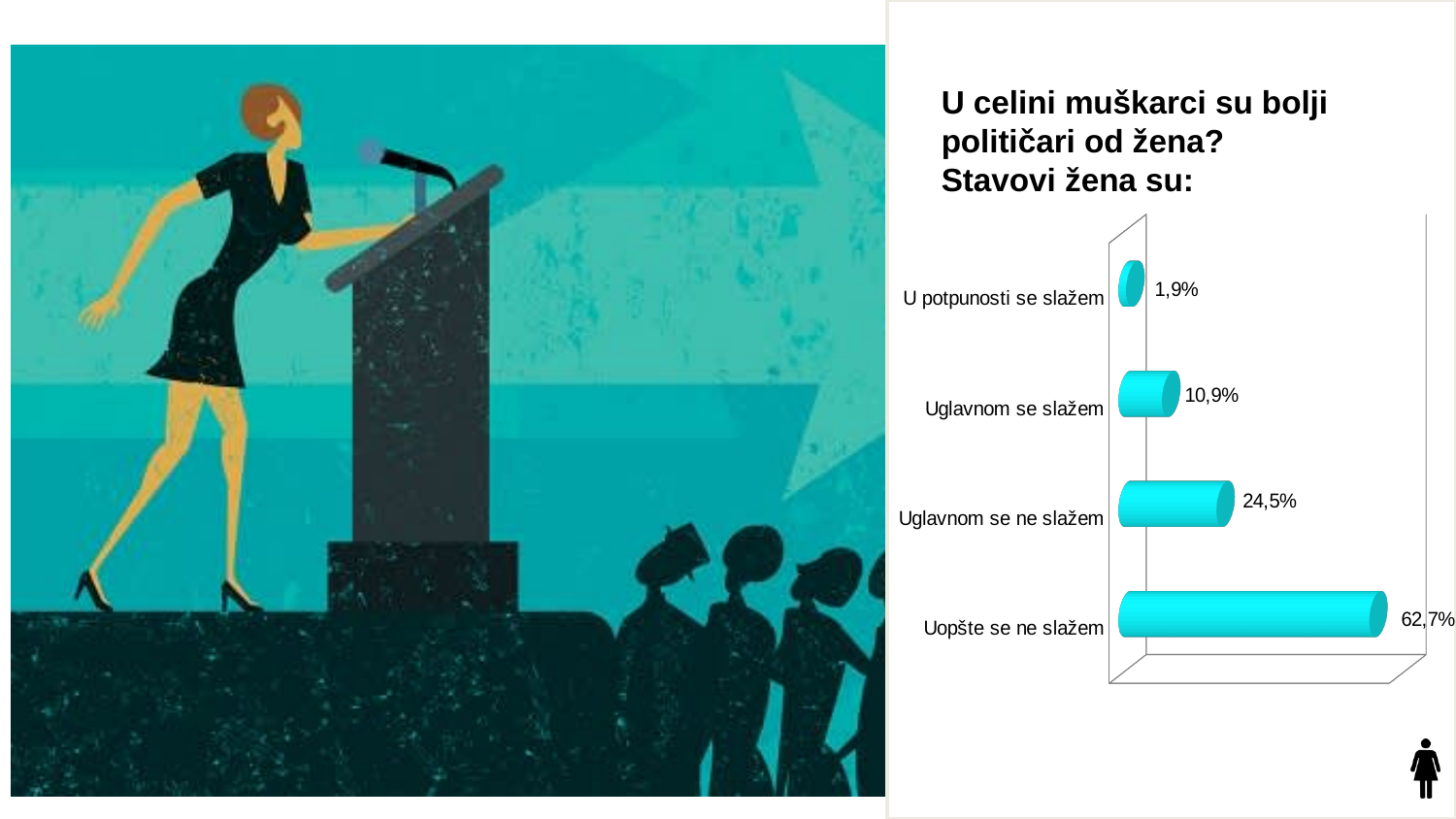
What is the value for "Uopšte se ne slažem"? 62,7% What is the difference between the values for "Uopšte se ne slažem" and "Uglavnom se ne slažem"? 38,2% What is the value for "Uglavnom se ne slažem"? 24,5% What is the title of the chart? U celini muškarci su bolji političari od žena? Stavovi žena su: How many categories are shown in the chart? 4 What is the difference between the values for "Uglavnom se slažem" and "U potpunosti se slažem"? 9,0% Which is larger, the value for "Uglavnom se ne slažem" or the value for "Uglavnom se slažem"? Uglavnom se ne slažem Which category has the highest value? Uopšte se ne slažem What is the value for "U potpunosti se slažem"? 1,9% Which category has the lowest value? U potpunosti se slažem What kind of chart is shown on the slide? Bar chart What is the value for "Uglavnom se slažem"? 10,9%